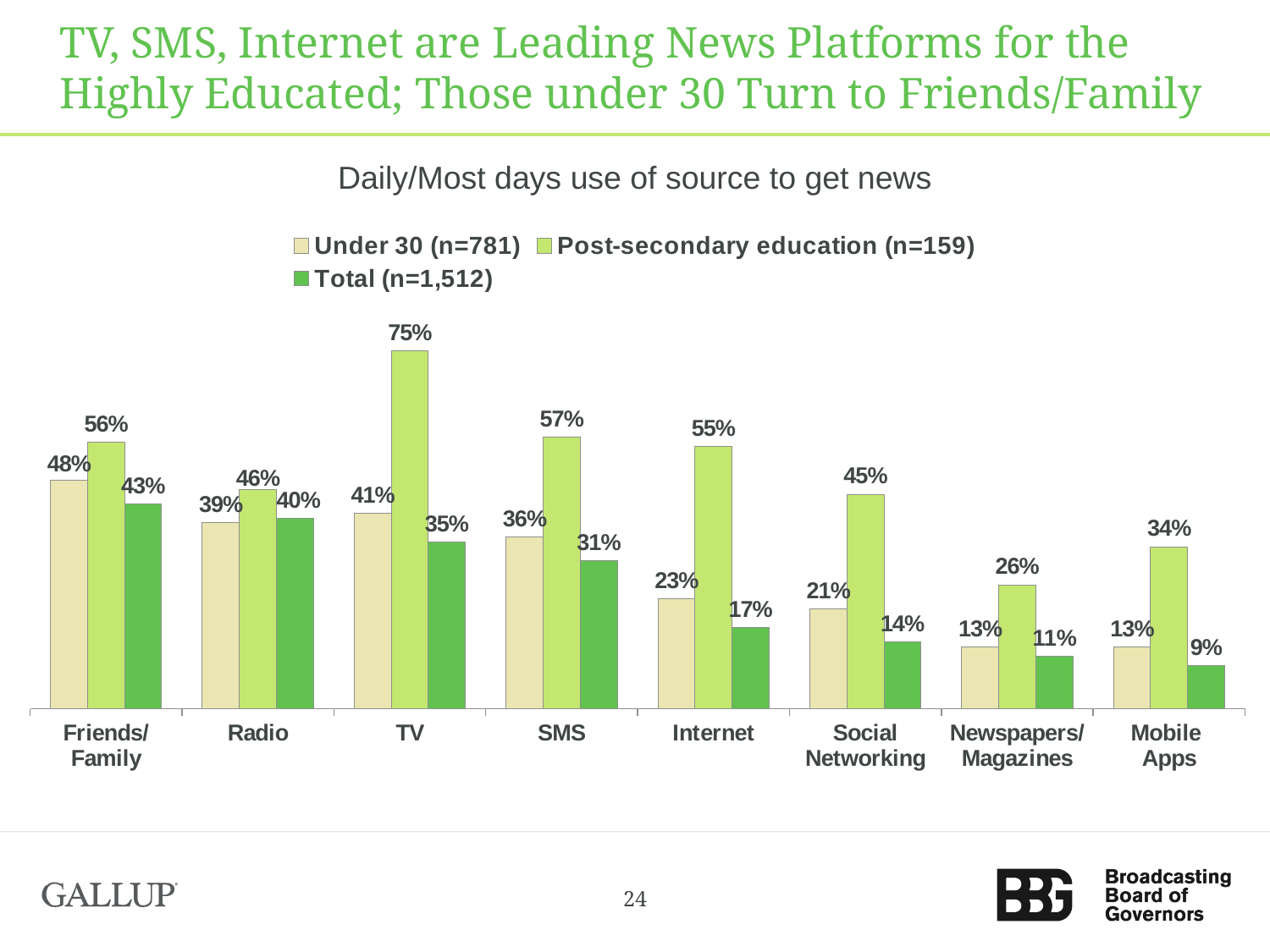
What is the difference between the Under 30 and Post-secondary education values for Social Networking? 24% Which is larger for Friends/Family: the Under 30 value or the Total value? Under 30 What percentage of the Post-secondary education group uses TV daily/most days to get news? 75% How many series does the legend list? 3 What is the difference between the Post-secondary education and Total values for TV? 40% What kind of chart is shown on the slide? Bar chart How many news sources are shown on the x axis? 8 What is the sample size (n) for the Total series shown in the legend? 1,512 What is the Total value for Mobile Apps? 9% What is the Under 30 value for Internet? 23% Which news source has the highest value for the Post-secondary education group? TV Which news source has the lowest Total value? Mobile Apps